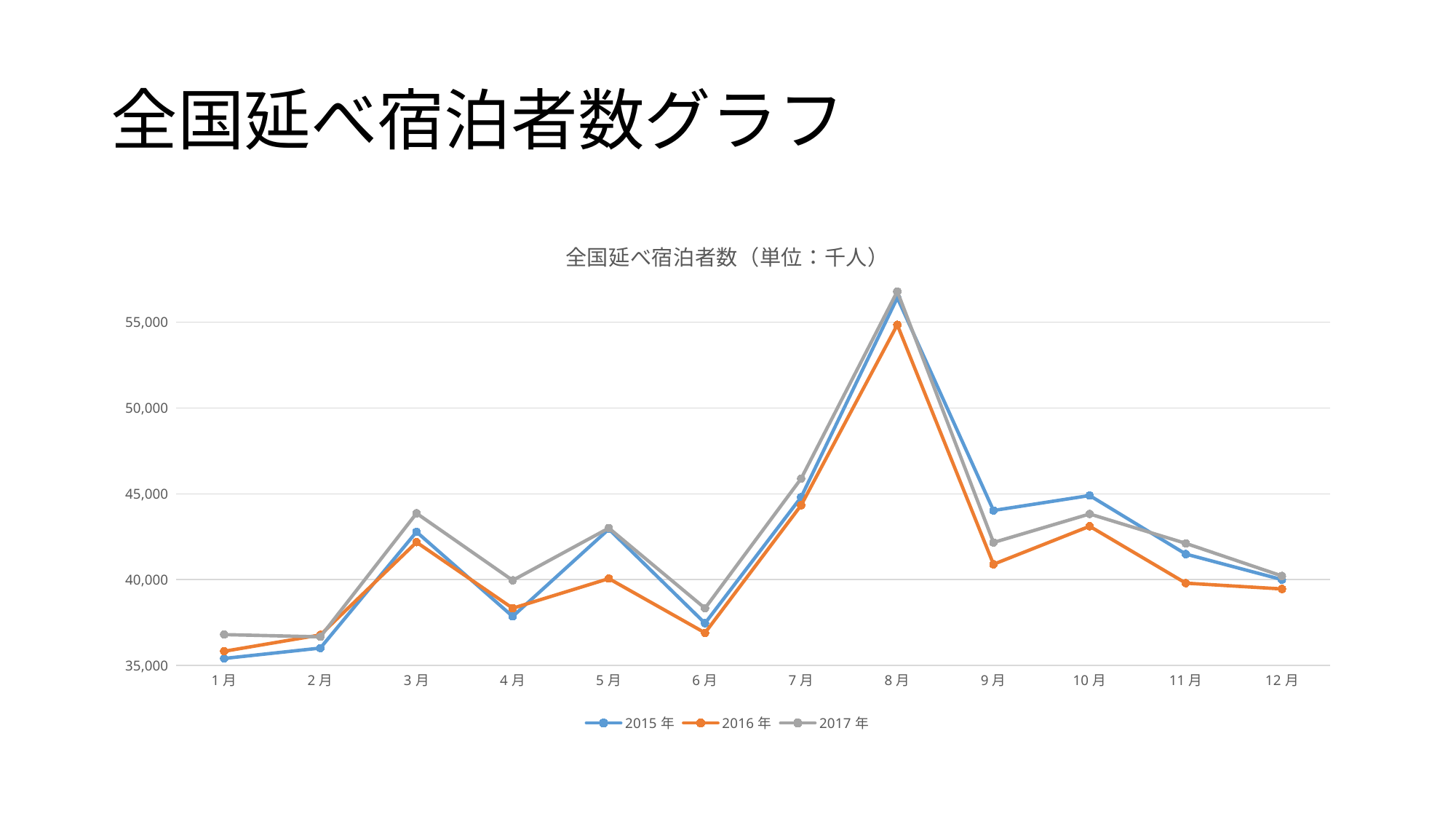
Is the value for 2017年 in 8月 greater or less than 55,000? greater What kind of chart is shown on the slide? line chart In which month does the 2015年 series have its lowest value? 1月 Is the value for 2017年 in 7月 greater or less than 45,000? greater What is the title of the chart? 全国延べ宿泊者数（単位：千人） How many series does the legend list? 3 In 10月, which series has the larger value, 2015年 or 2016年? 2015年 Is the value for 2016年 in 10月 greater or less than 45,000? less In which month does the 2015年 series reach its highest value? 8月 Do the values for 2016年 rise or fall from 8月 to 9月? fall How many months are plotted along the x axis? 12